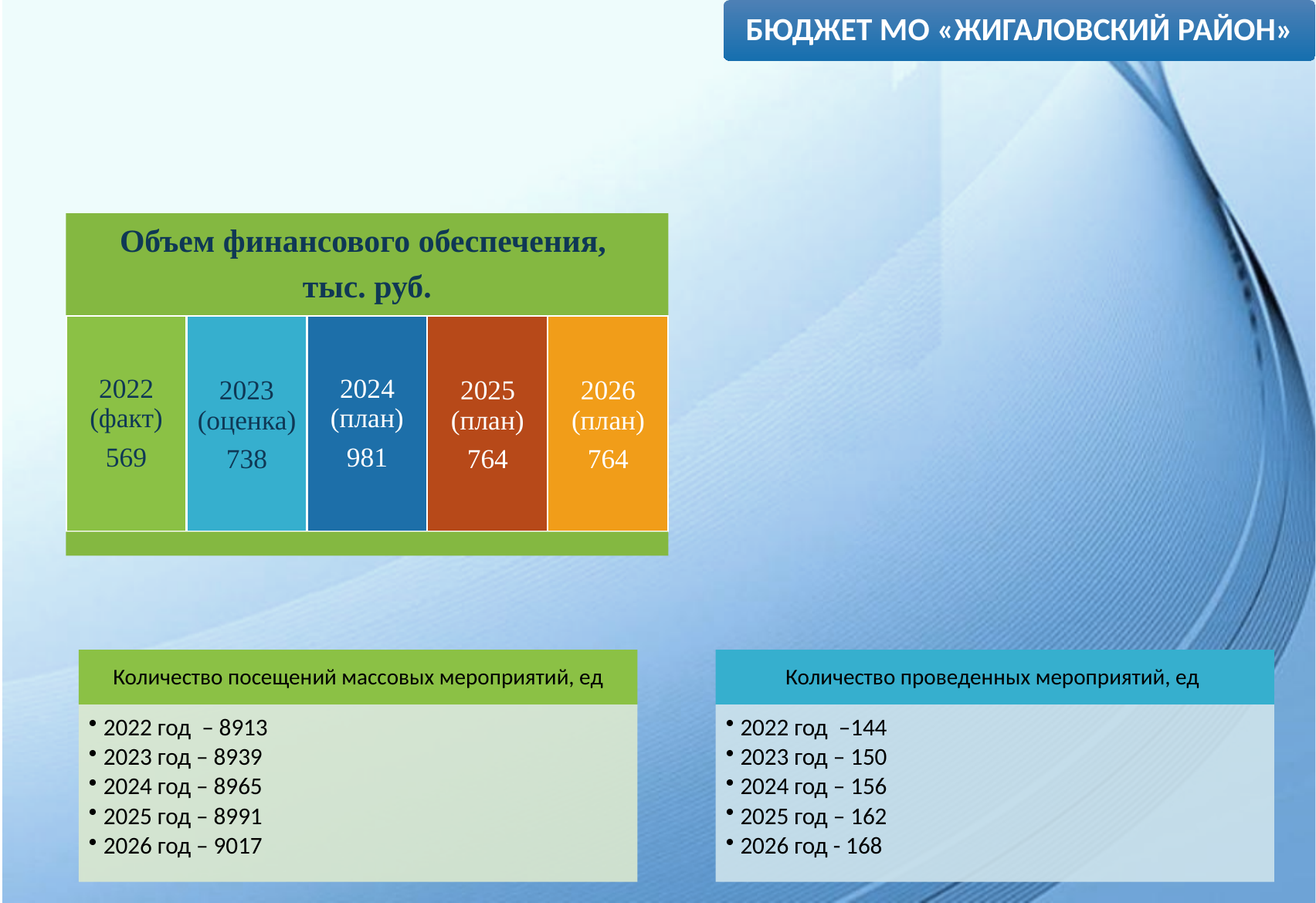
What is the difference between the values for 2024 (план) and 2025 (план)? 217 What is the difference between the values for 2024 (план) and 2022 (факт)? 412 What is the title of the chart on the slide? Объем финансового обеспечения, тыс. руб. What is the value for 2024 (план) in the chart? 981 Which is larger, the value for 2023 (оценка) or the value for 2025 (план)? 2025 (план) What is the value for 2023 (оценка) in the chart? 738 Do the values rise or fall from 2022 to 2024 in the chart? rise How many years are shown in the chart? 5 What is the value for 2026 (план) in the chart? 764 Which year has the lowest value in the chart? 2022 (факт) Which year has the highest value in the chart? 2024 (план) What is the value for 2022 (факт) in the chart? 569